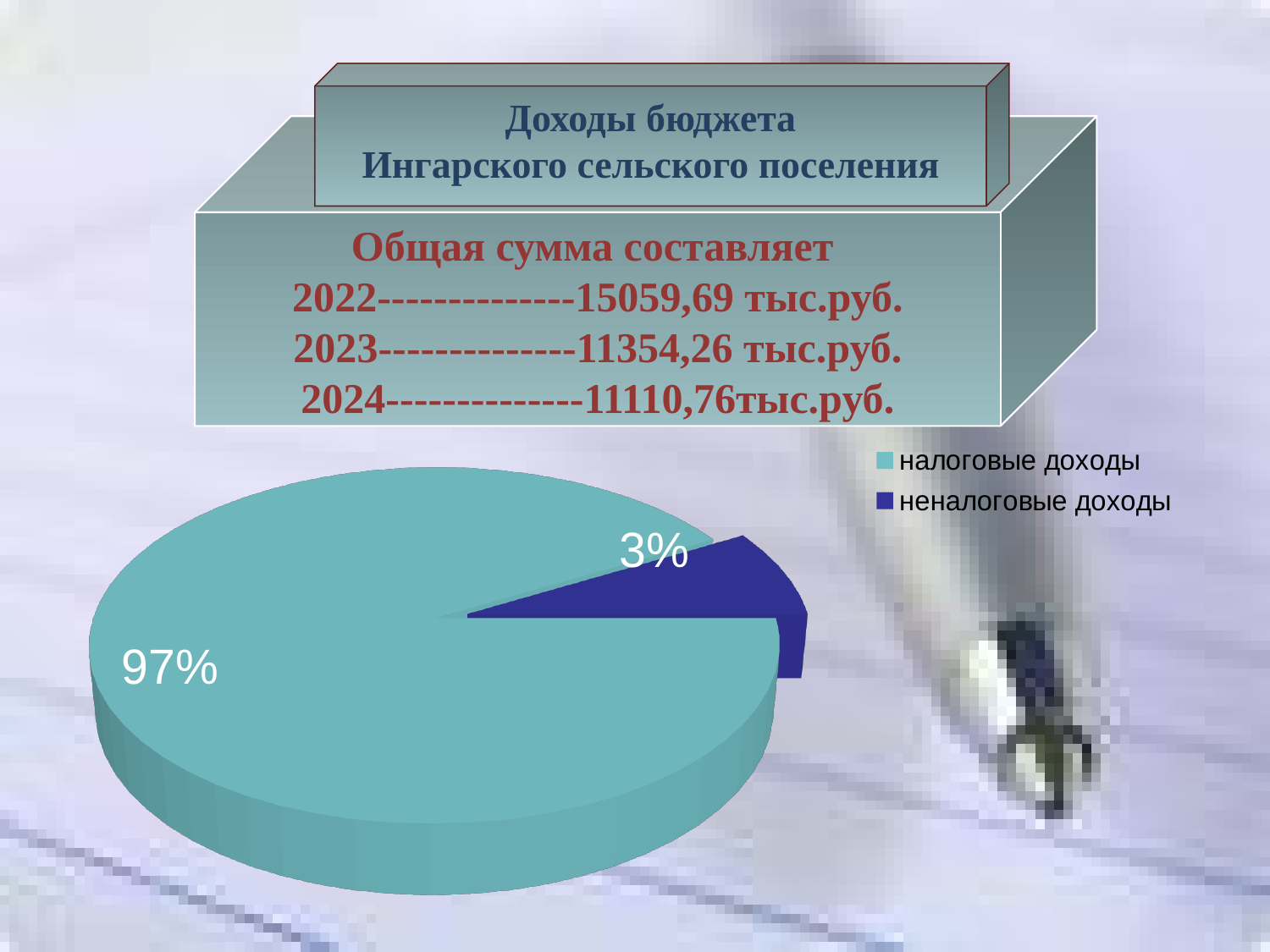
Which slice of the pie is the largest? налоговые доходы What colour is the неналоговые доходы slice in the pie chart? dark blue Which is larger, the share for налоговые доходы or the share for неналоговые доходы? налоговые доходы What share of the pie does неналоговые доходы take? 3% What is the difference in percentage points between the налоговые доходы slice and the неналоговые доходы slice? 94 What is the title shown above the chart on the slide? Доходы бюджета Ингарского сельского поселения Which slice of the pie is the smallest? неналоговые доходы How many slices does the pie chart have? 2 Is the share for налоговые доходы greater or less than 50%? greater What share of the pie does налоговые доходы take? 97% What kind of chart is shown on the slide? pie chart How many entries does the legend list? 2